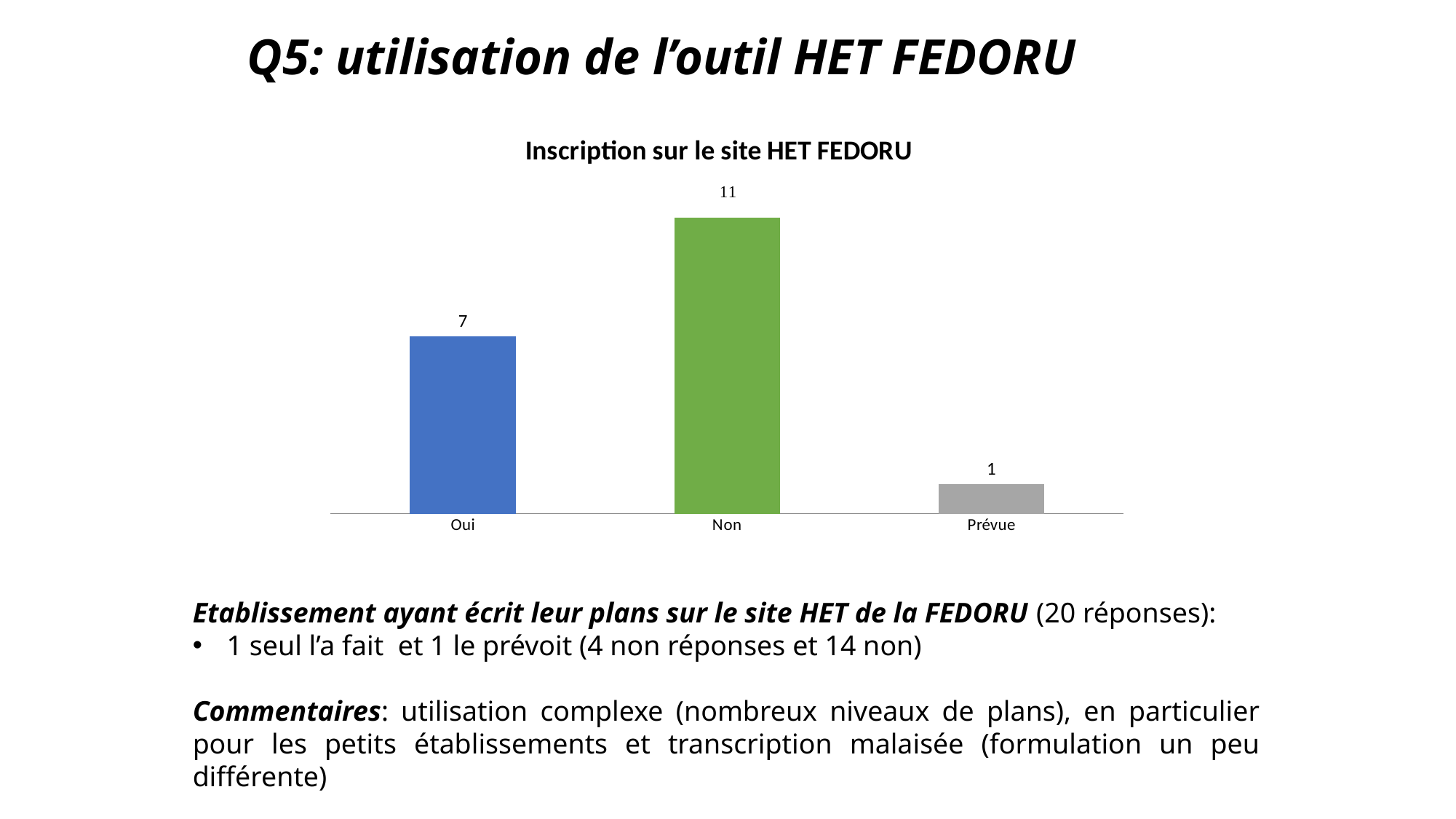
What colour is the bar for Non? green What is the difference between the values for Oui and Prévue? 6 What kind of chart is shown? bar chart What is the value for Prévue? 1 What is the value for Non? 11 Which is larger, the value for Oui or the value for Non? Non What is the value for Oui? 7 What is the title of the chart? Inscription sur le site HET FEDORU Which category has the highest value? Non How many categories are shown on the x axis? 3 What is the difference between the values for Non and Oui? 4 Which category has the lowest value? Prévue